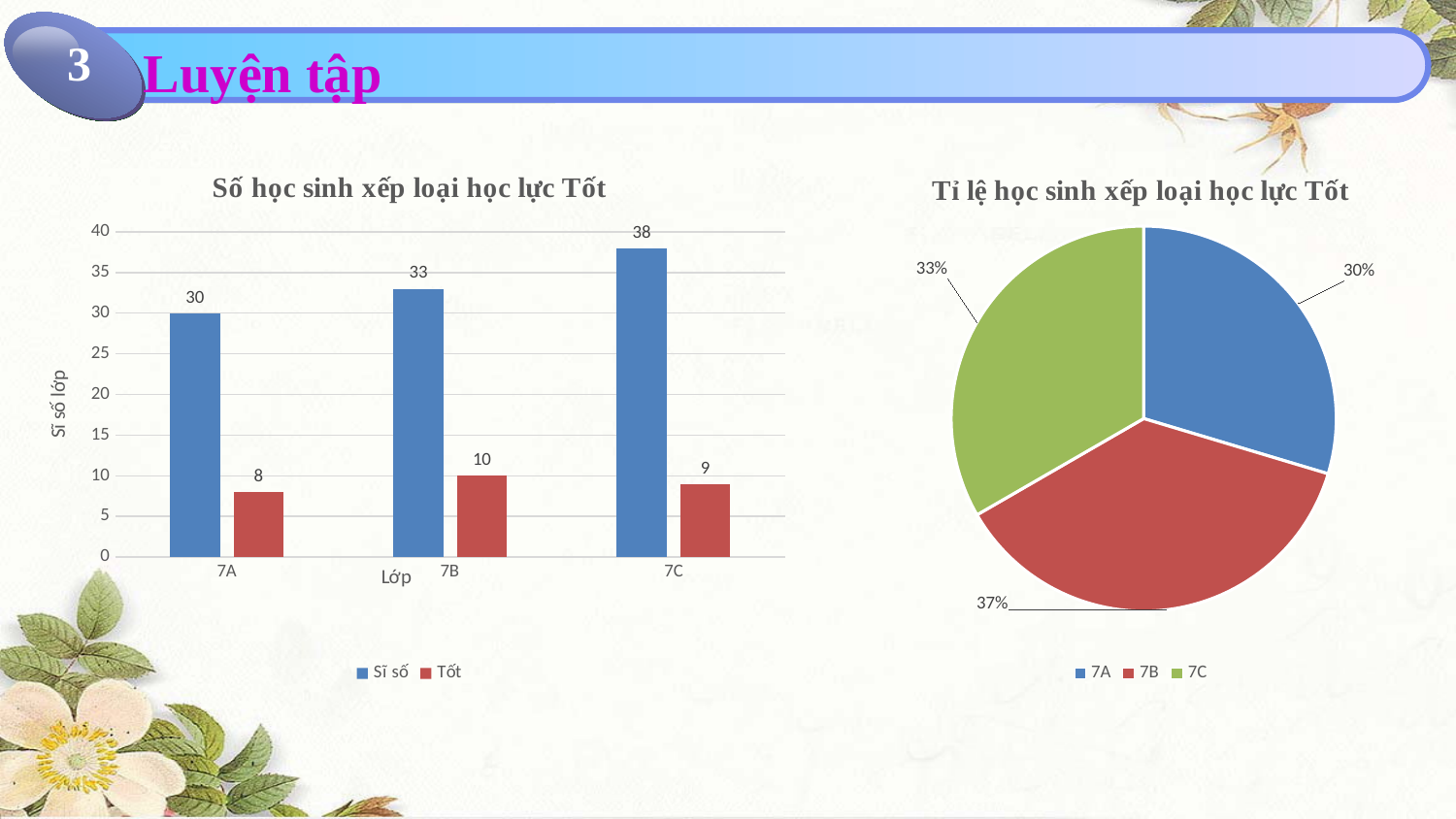
In the pie chart 'Tỉ lệ học sinh xếp loại học lực Tốt', which class has the smallest slice? 7A What kind of chart is the left chart 'Số học sinh xếp loại học lực Tốt'? bar chart In the bar chart 'Số học sinh xếp loại học lực Tốt', which class has the lowest Tốt value? 7A In the bar chart 'Số học sinh xếp loại học lực Tốt', how many classes are shown on the x axis? 3 In the bar chart 'Số học sinh xếp loại học lực Tốt', is the Tốt value for 7B larger or the Tốt value for 7C? 7B In the bar chart 'Số học sinh xếp loại học lực Tốt', how many series does the legend list? 2 In the bar chart 'Số học sinh xếp loại học lực Tốt', what is the Sĩ số value for class 7B? 33 In the pie chart 'Tỉ lệ học sinh xếp loại học lực Tốt', what share does class 7B have? 37% In the bar chart 'Số học sinh xếp loại học lực Tốt', what is the difference between the Sĩ số and Tốt values for class 7A? 22 In the bar chart 'Số học sinh xếp loại học lực Tốt', which class has the highest Sĩ số? 7C In the bar chart 'Số học sinh xếp loại học lực Tốt', what is the Tốt value for class 7C? 9 In the pie chart 'Tỉ lệ học sinh xếp loại học lực Tốt', what colour is the slice for class 7C? green